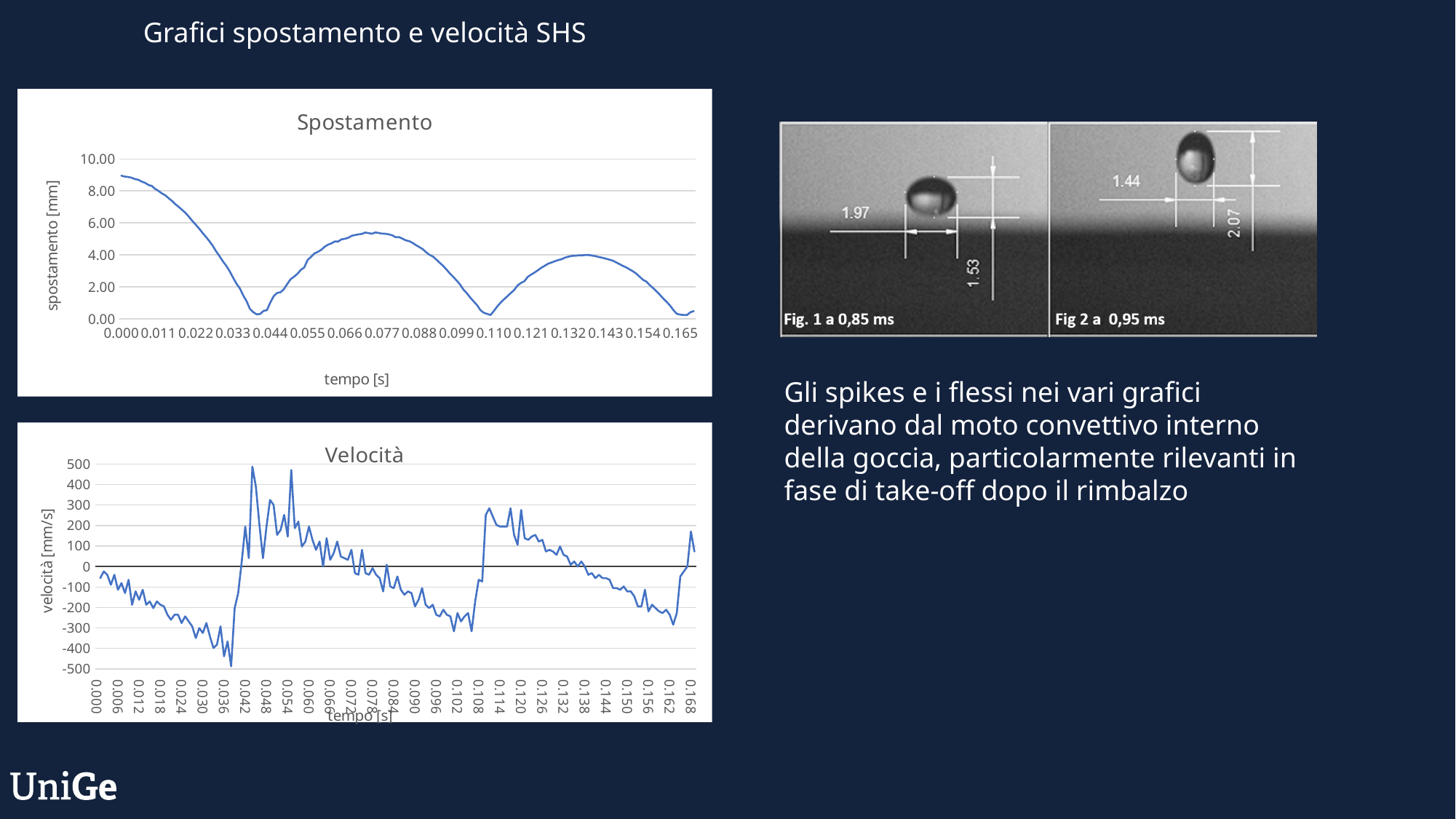
On the Velocità chart, is the lowest value greater or less than -400? less On the Spostamento chart, at which time is the displacement highest? 0.000 On the Spostamento chart, is the value at time 0.110 greater or less than 2.00? less On the Spostamento chart, what is the y-axis label? spostamento [mm] On the Spostamento chart, is the value at time 0.077 greater or less than 4.00? greater On the Velocità chart, what is the y-axis label? velocità [mm/s] What kind of chart is the Spostamento chart? line chart On the Spostamento chart, which is higher: the peak near time 0.077 or the peak near time 0.138? the peak near 0.077 What kind of chart is the Velocità chart? line chart On the Spostamento chart, does the value rise or fall between time 0.000 and time 0.033? fall